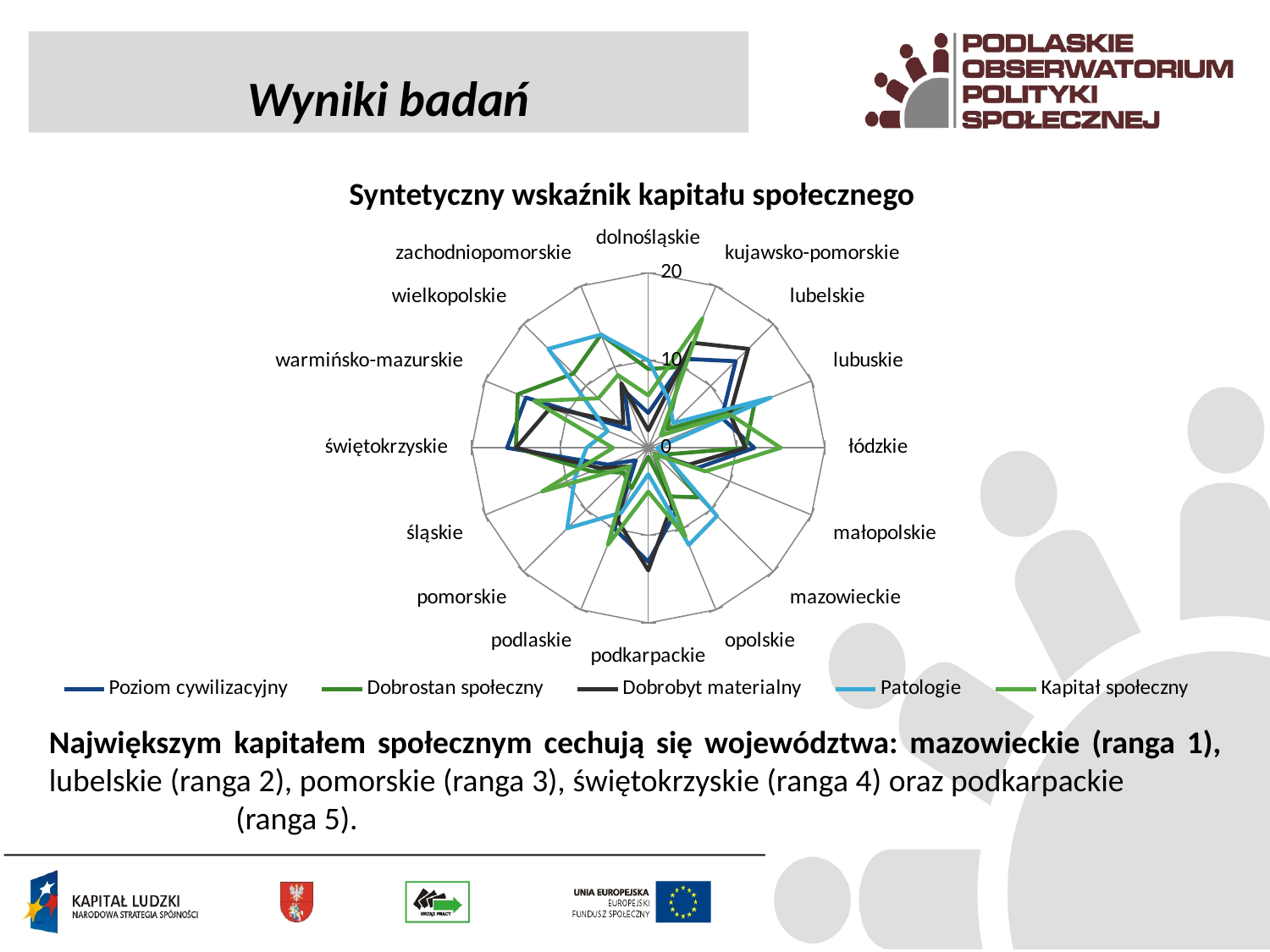
How many series does the chart legend list? 5 Is the value of Dobrobyt materialny for mazowieckie greater or less than 10? less Is the value of Dobrobyt materialny for lubelskie greater or less than 10? greater What is the title of the chart? Syntetyczny wskaźnik kapitału społecznego What kind of chart is shown on the slide? Radar chart Which series is listed first in the chart legend? Poziom cywilizacyjny Is the value of Patologie for lubuskie greater or less than 10? greater What is the highest value shown on the chart's radial axis? 20 How many categories (voivodeships) are plotted on the radar chart? 16